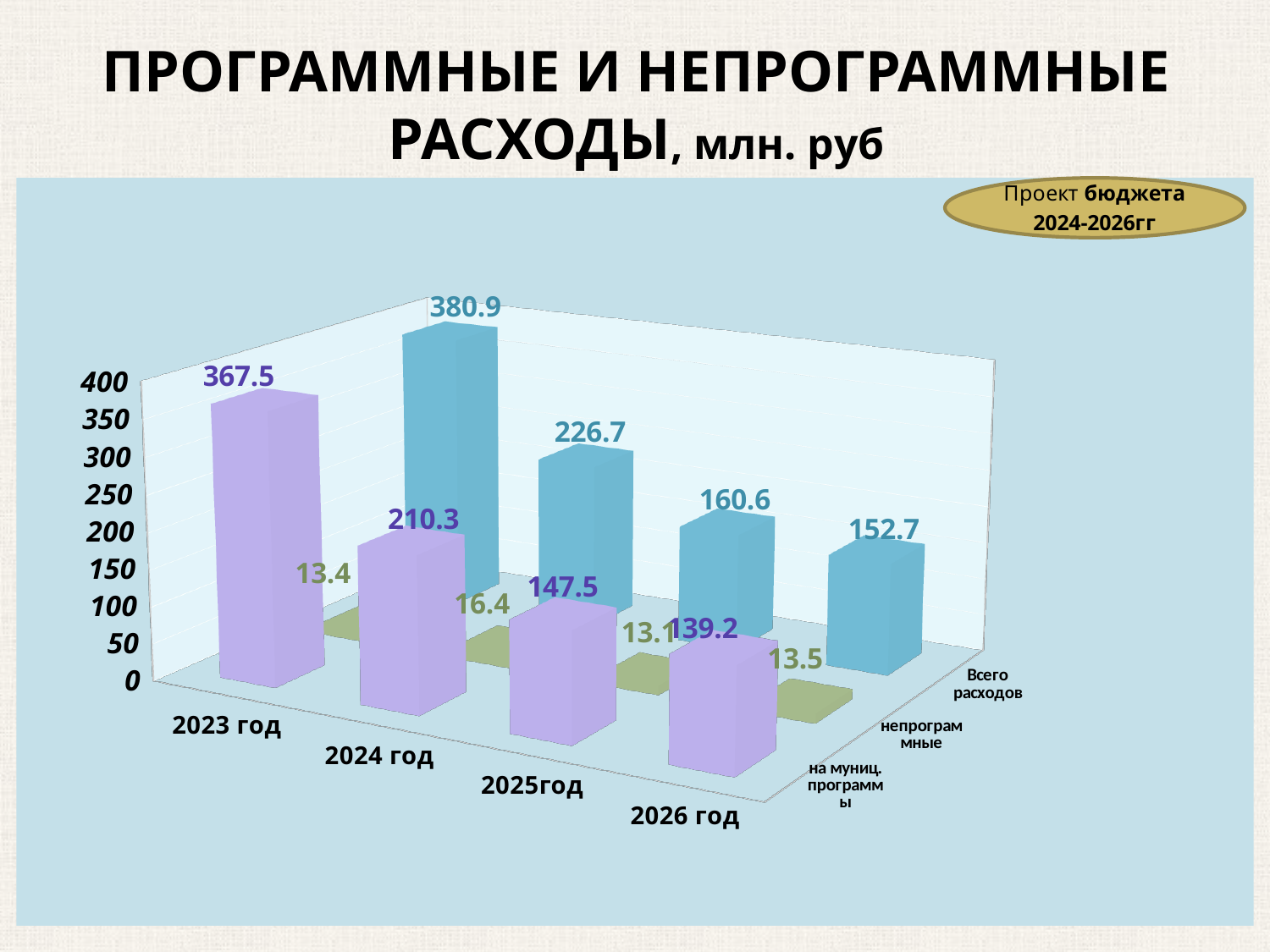
Do the values for 'Всего расходов' rise or fall from 2023 год to 2026 год? Fall What is the difference between 'Всего расходов' in 2023 год and in 2024 год? 154.2 Which year has the lowest value for 'на муниц. программы'? 2026 год Which year has the highest value for 'Всего расходов'? 2023 год What is the value for 'непрограммные' in 2026 год? 13.5 What is the value for 'на муниц. программы' in 2025год? 147.5 What is the value for 'Всего расходов' in 2024 год? 226.7 Which is larger: 'на муниц. программы' in 2024 год or in 2025год? 2024 год What kind of chart is shown on the slide? Bar chart How many years are shown on the chart? 4 What is the value for 'на муниц. программы' in 2023 год? 367.5 What is the difference between 'на муниц. программы' and 'непрограммные' in 2023 год? 354.1